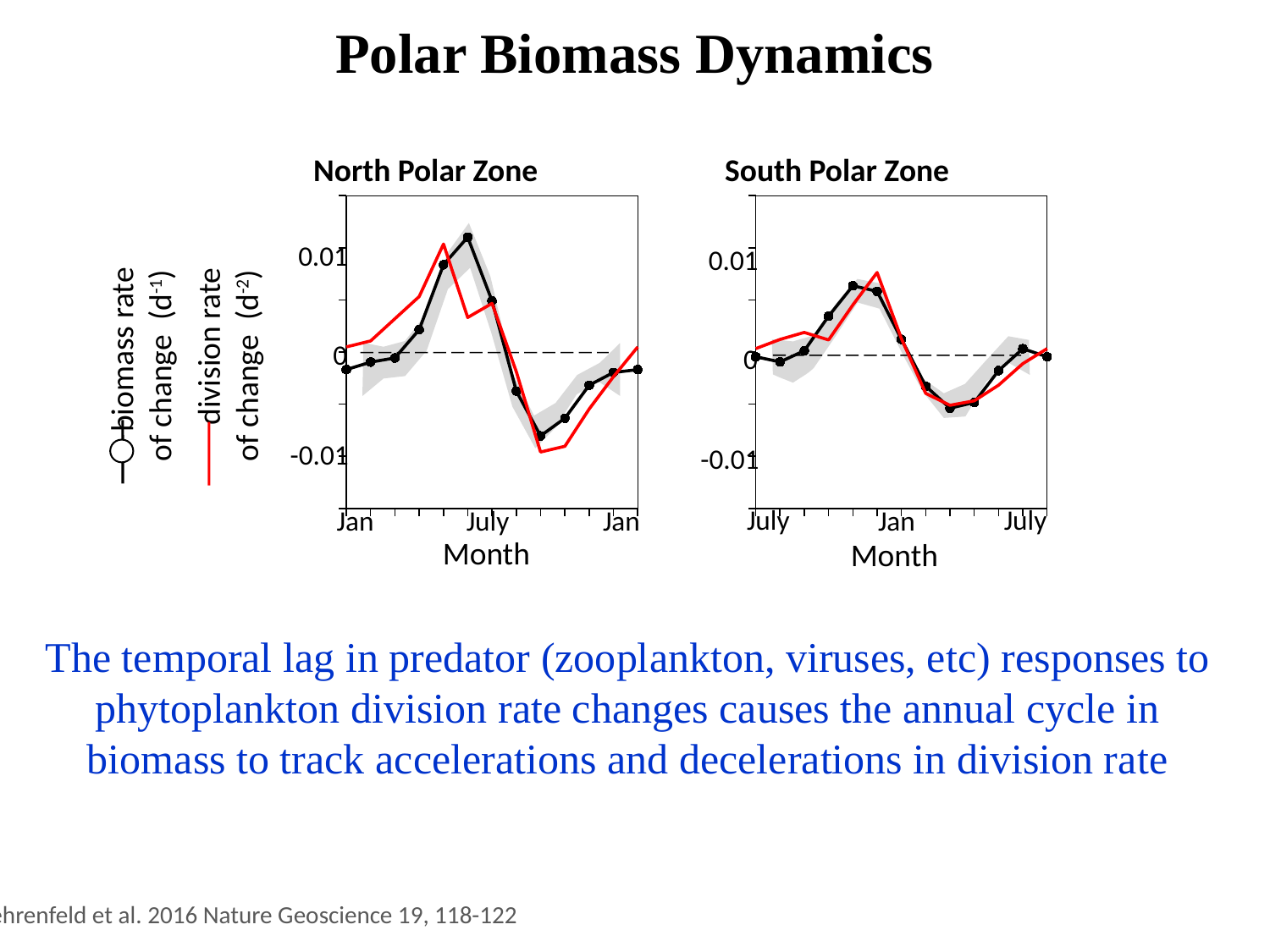
What is the label on the x axis of both charts? Month In the North Polar Zone chart, is the peak value of the biomass rate of change greater or less than 0.01? greater In the North Polar Zone chart, is the lowest value of the biomass rate of change greater or less than -0.01? greater In the North Polar Zone chart, does the biomass rate of change rise or fall between Jan and its peak near July? rise In the South Polar Zone chart, is the peak value of the biomass rate of change greater or less than 0.01? less What kind of chart is the North Polar Zone chart? line chart What colour is the line for division rate of change? red How many series does the legend list for the charts? 2 In the South Polar Zone chart, does the biomass rate of change rise or fall immediately after its peak near Jan? fall Which chart shows the higher peak in biomass rate of change, North Polar Zone or South Polar Zone? North Polar Zone